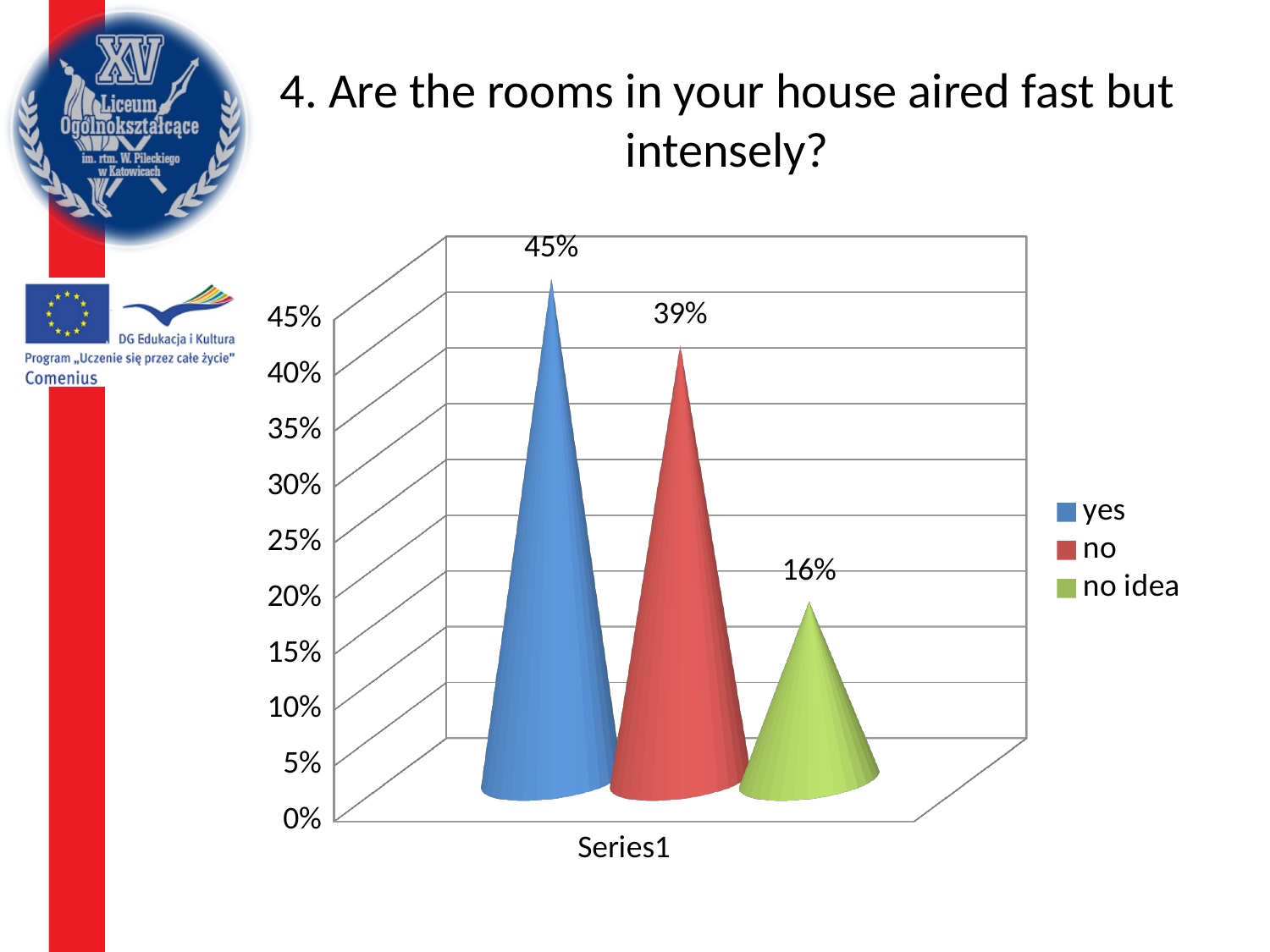
Which answer has the highest percentage? yes What percentage of respondents answered "no idea"? 16% What kind of chart is shown on the slide? bar chart Which is larger, the percentage for "no" or for "no idea"? no What is the difference between the "yes" and "no" percentages? 6% What colour represents the "no idea" answer in the legend? green Is the value for "no idea" greater or less than 20%? less How many series does the legend list? 3 What percentage of respondents answered "no"? 39% What percentage of respondents answered "yes"? 45% Which answer has the lowest percentage? no idea What is the difference between the "no" and "no idea" percentages? 23%